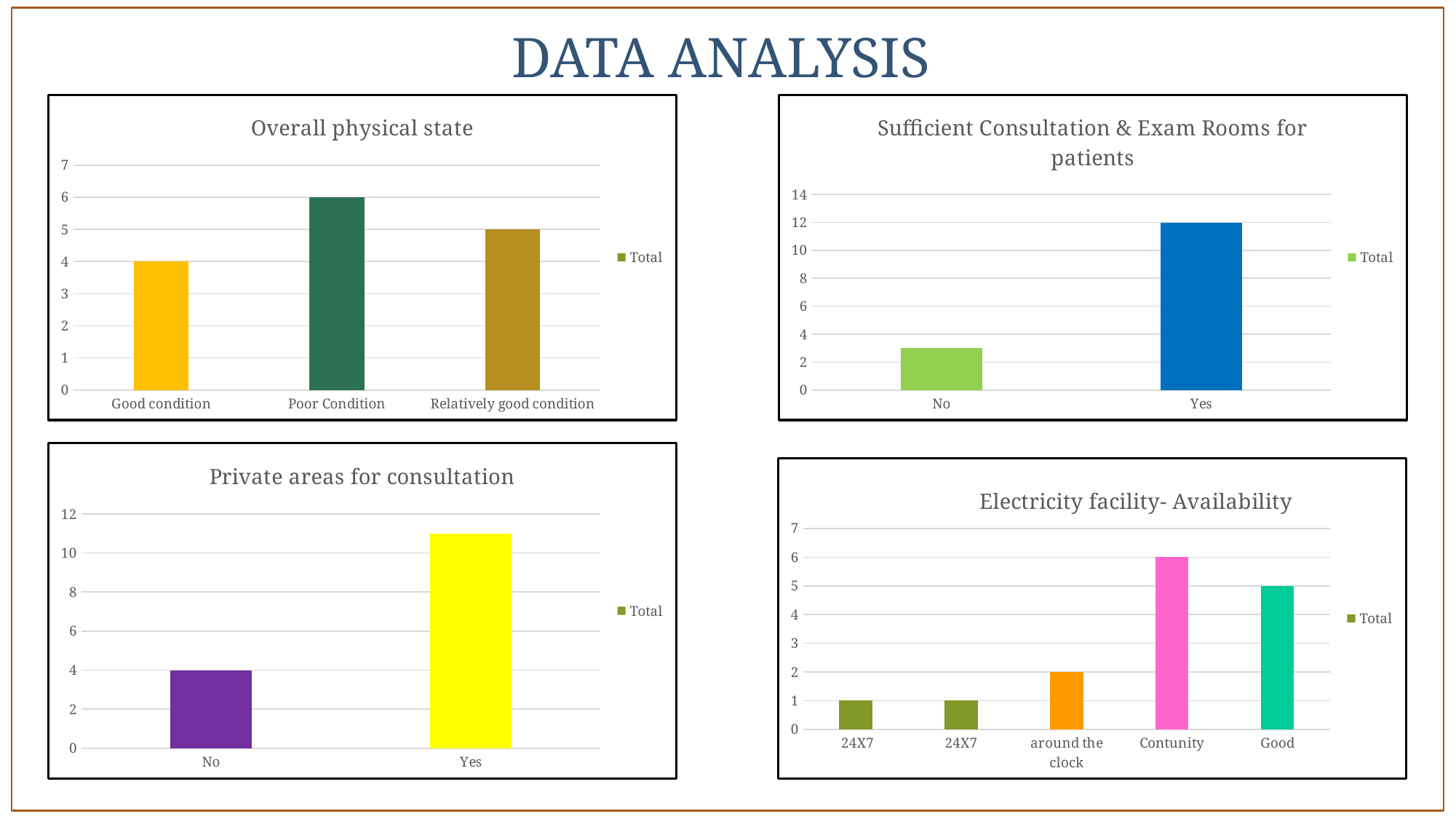
In the 'Private areas for consultation' chart, what is the value for No? 4 In the 'Overall physical state' chart, what is the difference between Poor Condition and Good condition? 2 In the 'Overall physical state' chart, which category has the lowest value? Good condition In the 'Electricity facility- Availability' chart, what is the value for around the clock? 2 In the 'Sufficient Consultation & Exam Rooms for patients' chart, is the value for No greater or less than 4? less In the 'Sufficient Consultation & Exam Rooms for patients' chart, what is the value for Yes? 12 In the 'Electricity facility- Availability' chart, which category has the highest value? Contunity In the 'Private areas for consultation' chart, is the value for Yes greater or less than 10? greater What type of chart is 'Private areas for consultation'? Bar chart In the 'Overall physical state' chart, what is the value for Poor Condition? 6 In the 'Electricity facility- Availability' chart, which is larger, Contunity or Good? Contunity How many categories are shown in the 'Electricity facility- Availability' chart? 5